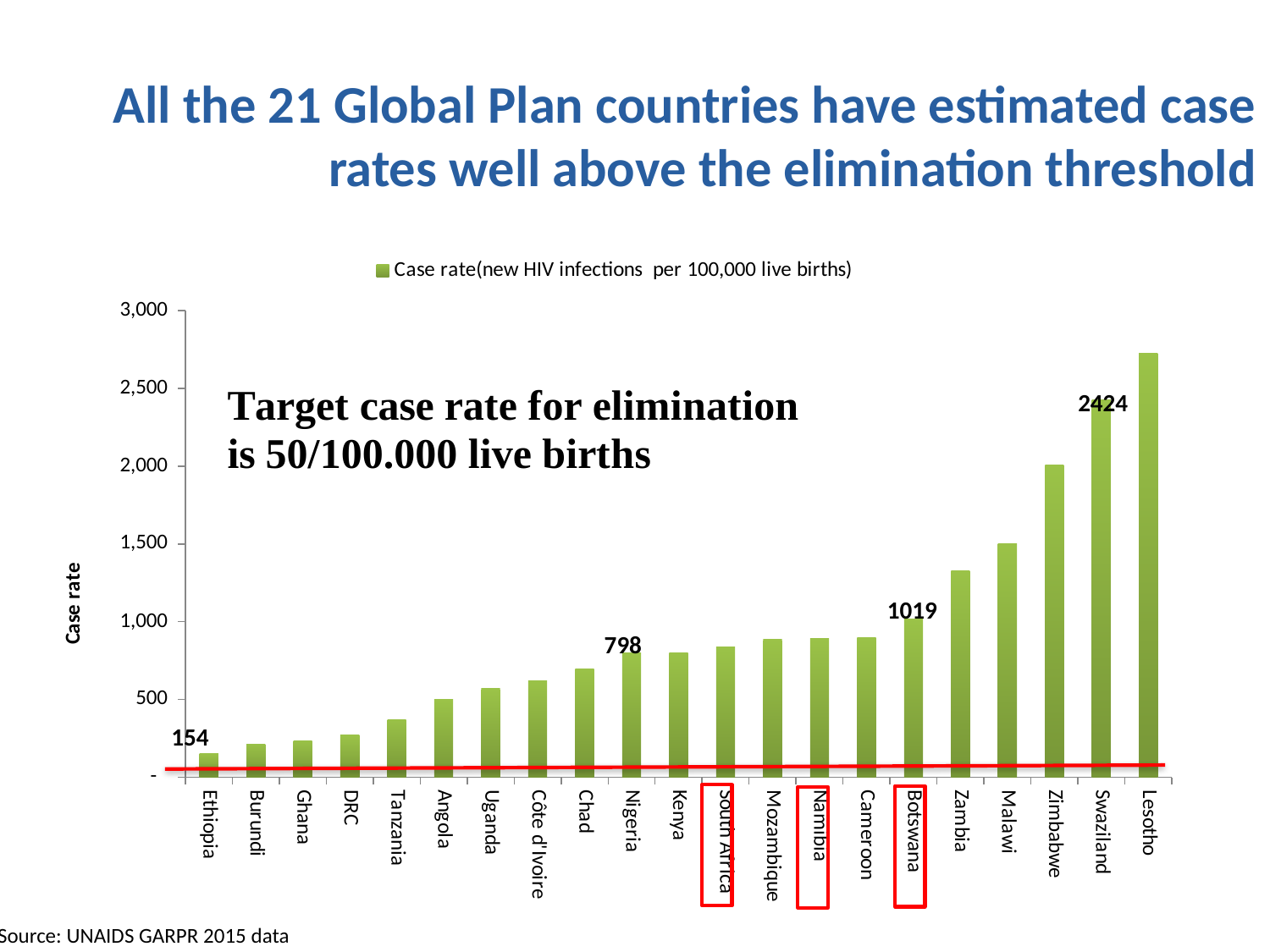
What is the difference between the case rates of Swaziland and Ethiopia? 2270 What is the case rate for Ethiopia? 154 What is the case rate for Nigeria? 798 Which country has the highest case rate? Lesotho Do the case rates rise or fall from left to right along the x axis? Rise What kind of chart is shown on the slide? Bar chart Which country has the lowest case rate? Ethiopia What is the case rate for Swaziland? 2424 What is the case rate for Botswana? 1019 Which has a higher case rate, Nigeria or Botswana? Botswana Is the case rate for Lesotho greater or less than 2,500? greater How many countries are shown on the chart? 21